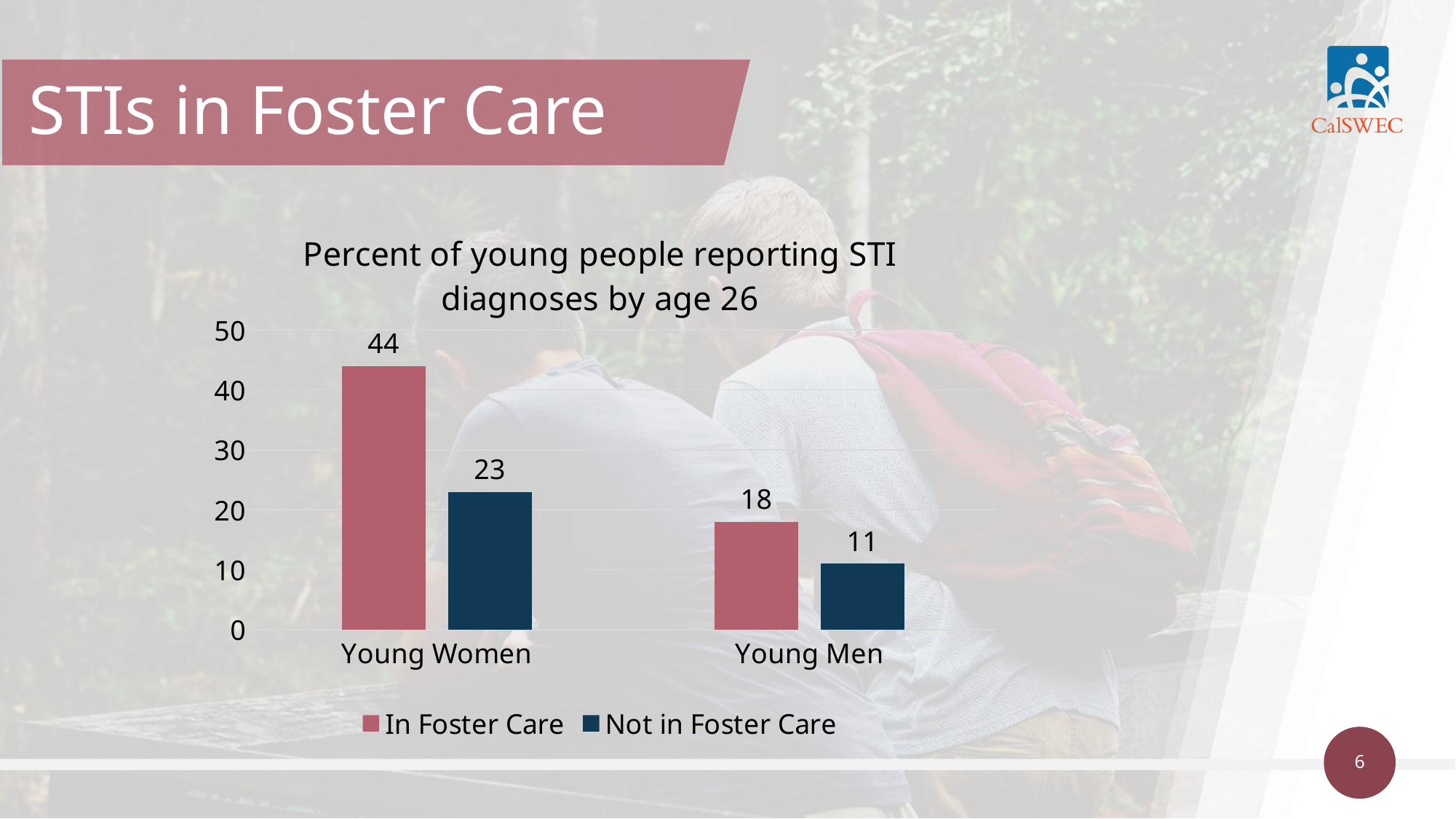
What is the title of the chart? Percent of young people reporting STI diagnoses by age 26 What kind of chart is shown on the slide? Bar chart Which bar has the lowest value on the chart? Young Men, Not in Foster Care How many series does the legend list? 2 What is the value for Young Women in the In Foster Care series? 44 What is the value for Young Men in the In Foster Care series? 18 What is the difference between the In Foster Care and Not in Foster Care values for Young Women? 21 What is the difference between the In Foster Care values for Young Women and Young Men? 26 What is the value for Young Women in the Not in Foster Care series? 23 What is the value for Young Men in the Not in Foster Care series? 11 Which is larger: the In Foster Care value for Young Men or the Not in Foster Care value for Young Women? Not in Foster Care value for Young Women Which bar has the highest value on the chart? Young Women, In Foster Care